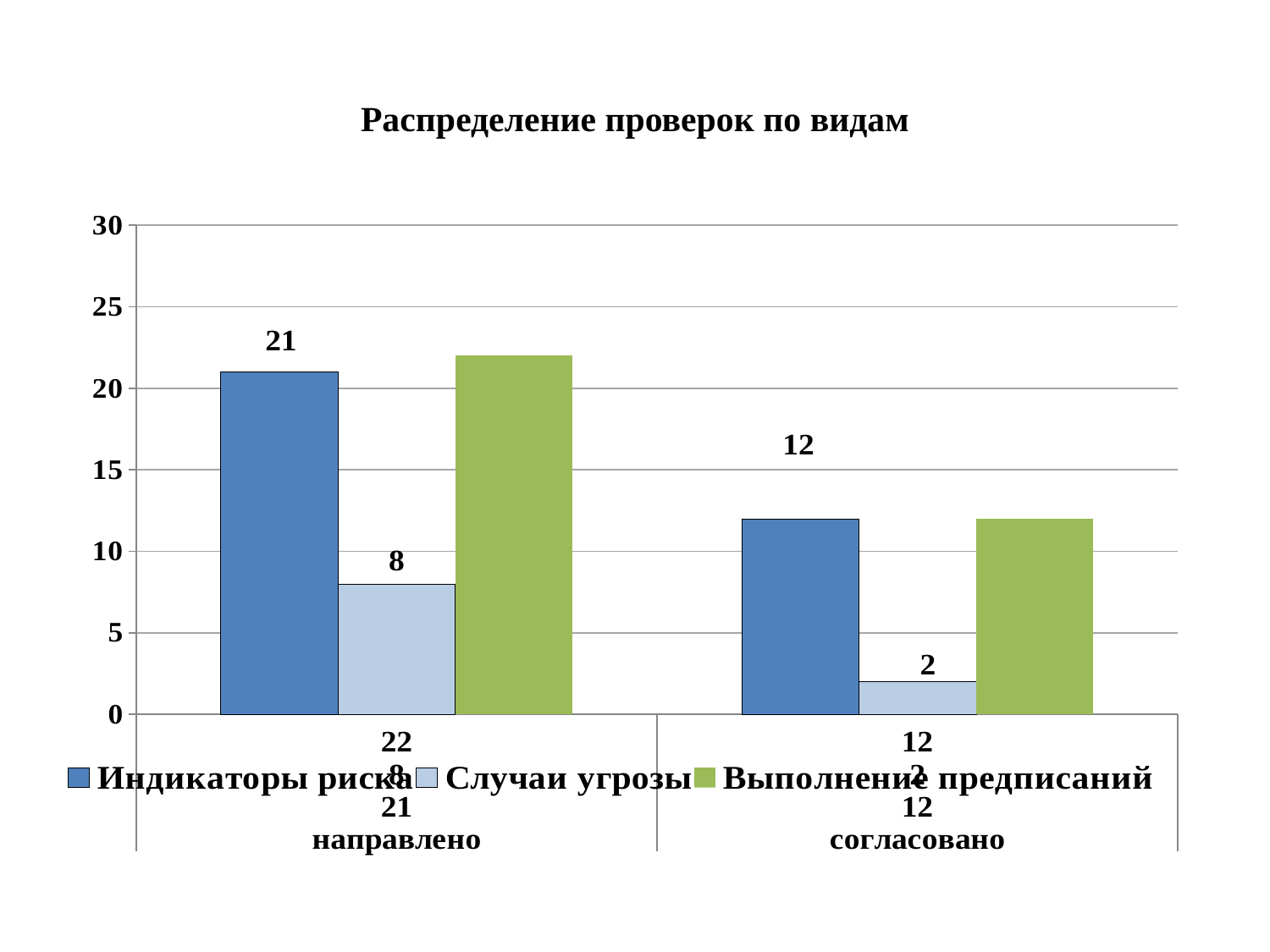
What is the value of Индикаторы риска for согласовано? 12 How many series does the legend list? 3 Is the value of Выполнение предписаний for направлено greater or less than 20? greater By how much does Индикаторы риска for направлено exceed Индикаторы риска for согласовано? 9 How many categories are shown on the x axis? 2 What type of chart is shown on the slide? bar chart In the направлено category, which is larger: Индикаторы риска or Случаи угрозы? Индикаторы риска What is the difference between Случаи угрозы for направлено and Случаи угрозы for согласовано? 6 What is the value of Случаи угрозы for согласовано? 2 What is the value of Индикаторы риска for направлено? 21 What is the value of Случаи угрозы for направлено? 8 Which bar has the lowest value on the chart? Случаи угрозы for согласовано